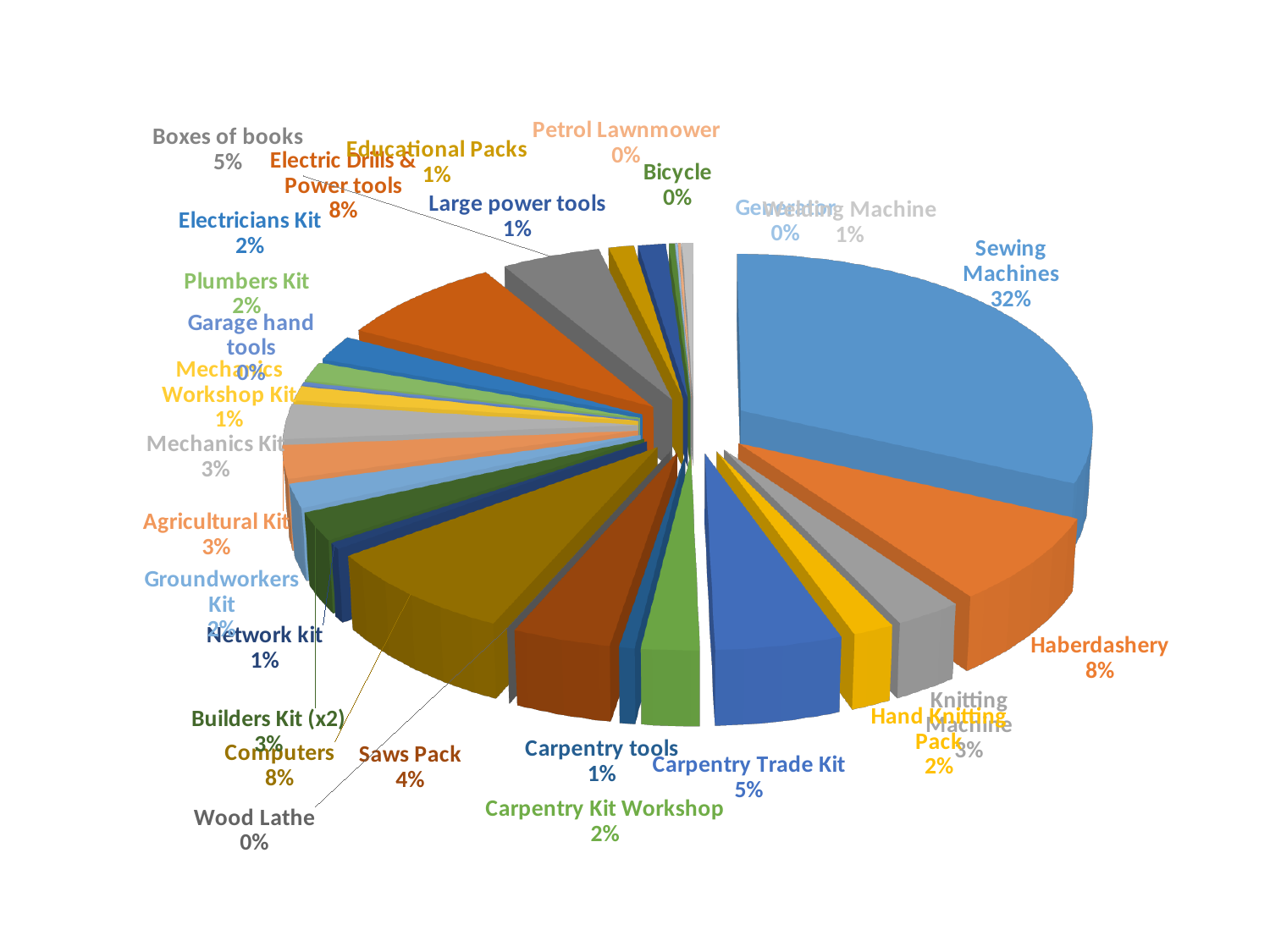
Which category has the largest share of the pie? Sewing Machines What share of the pie is Boxes of books? 5% Which is larger, the share for Sewing Machines or the share for Haberdashery? Sewing Machines What share of the pie is Electric Drills & Power tools? 8% What kind of chart is shown on the slide? pie chart What share of the pie is Wood Lathe? 0% What is the difference in percentage points between Sewing Machines and Computers? 24